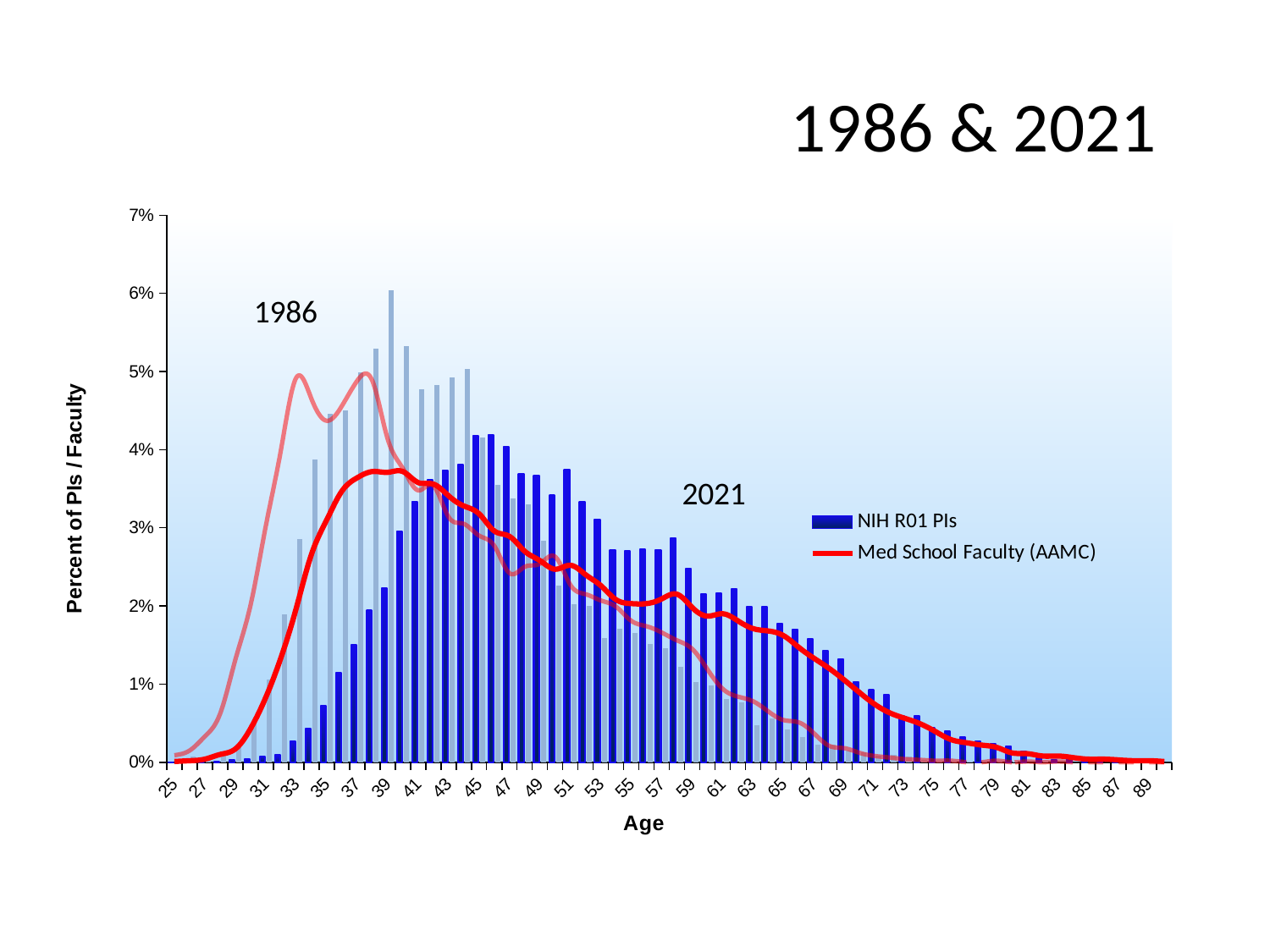
At which age is the 1986 NIH R01 PIs bar highest? 39 At age 40, which is larger: the 1986 NIH R01 PIs bar or the 2021 NIH R01 PIs bar? 1986 What label is shown on the vertical axis of the chart? Percent of PIs / Faculty At age 60, which is larger: the 1986 NIH R01 PIs bar or the 2021 NIH R01 PIs bar? 2021 How many series does the legend list? 2 Is the 2021 NIH R01 PIs value at age 30 greater or less than 1%? less What kind of chart is shown on the slide? A bar chart with line series Is the 2021 NIH R01 PIs value at age 65 greater or less than 3%? less Do the 2021 NIH R01 PIs values generally rise or fall from age 60 to age 89? fall Is the 2021 NIH R01 PIs value at age 45 greater or less than 3%? greater What is the title of the slide? 1986 & 2021